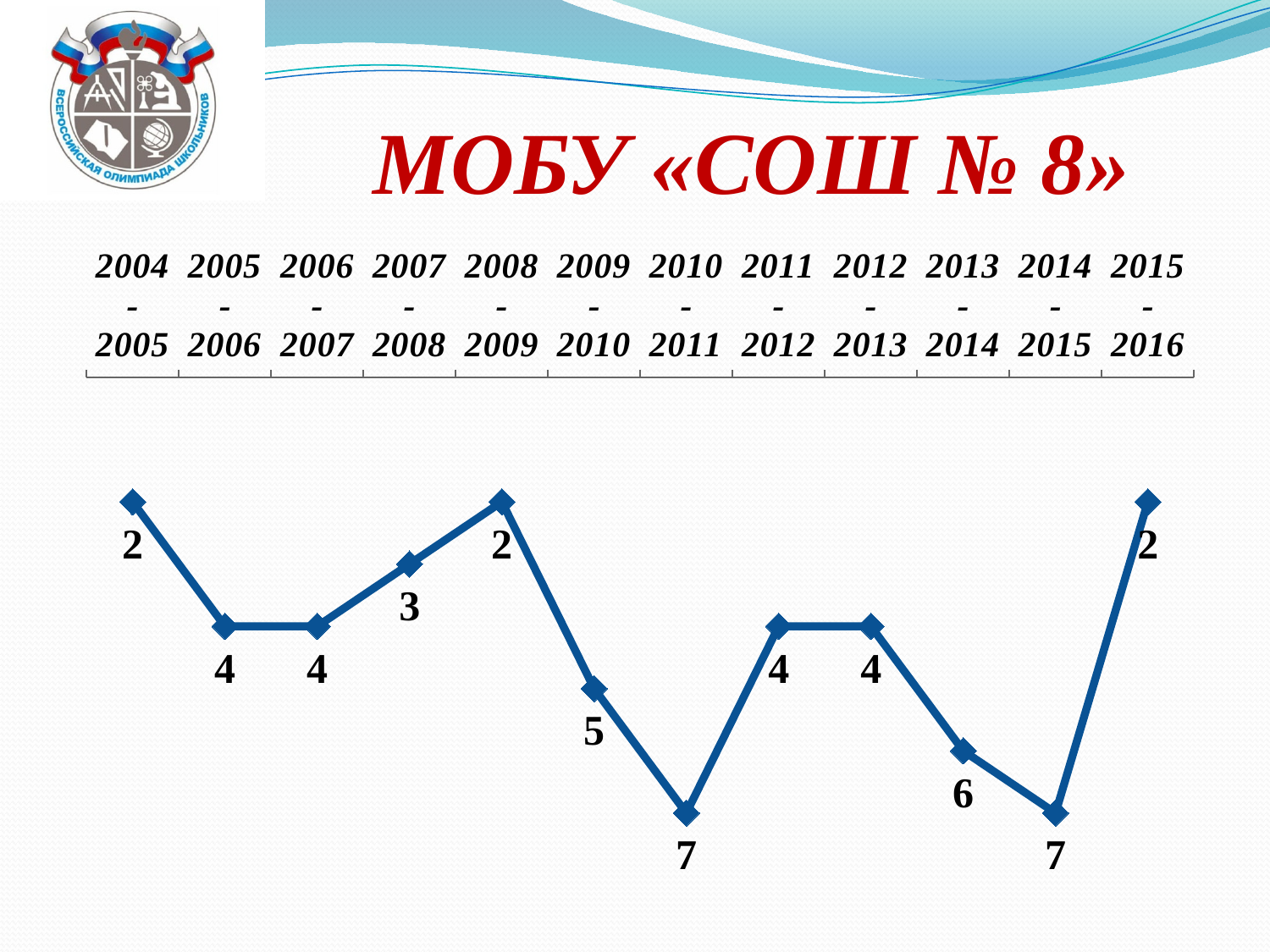
What type of chart is shown on the slide? line chart What is the value for 2007-2008? 3 What is the value for 2015-2016? 2 What is the value for 2013-2014? 6 What is the difference between the values for 2014-2015 and 2015-2016? 5 What is the value for 2004-2005? 2 How many data points are plotted on the chart? 12 Which has the larger value, 2009-2010 or 2008-2009? 2009-2010 What is the title of the slide containing the chart? МОБУ «СОШ № 8» What is the value for 2010-2011? 7 What is the difference between the values for 2010-2011 and 2011-2012? 3 What is the value for 2009-2010? 5